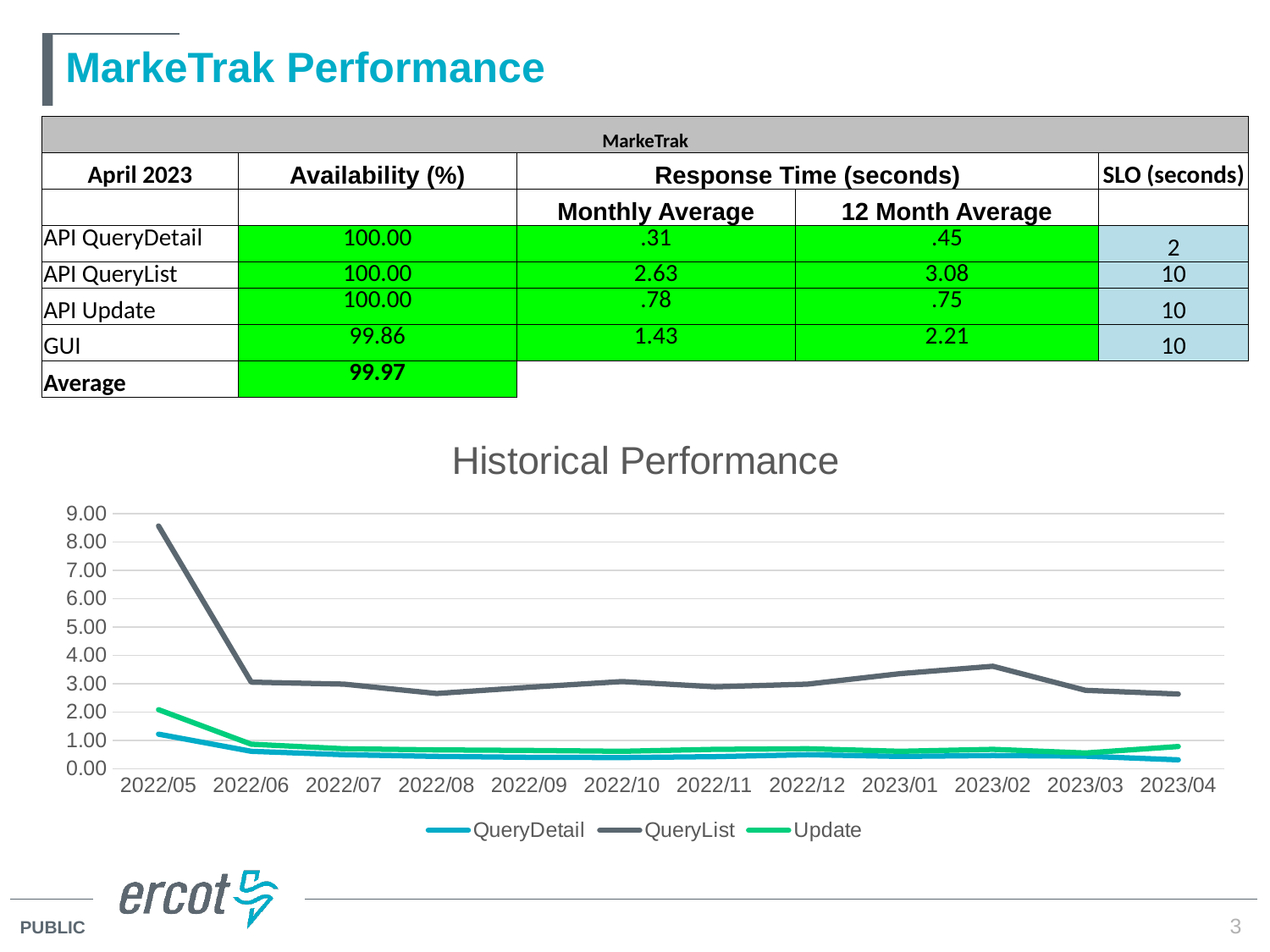
In the Historical Performance chart, is the QueryList value for 2022/05 greater or less than 8.00? greater In the Historical Performance chart, is the QueryList value for 2022/06 greater or less than 4.00? less What is the title of the line chart on the slide? Historical Performance In the Historical Performance chart, which series has the lowest value at 2023/04? QueryDetail How many months are plotted along the x axis of the Historical Performance chart? 12 In the Historical Performance chart, does the QueryList line rise or fall from 2022/05 to 2022/06? fall How many series does the legend of the Historical Performance chart list? 3 In the Historical Performance chart, is the QueryDetail value for 2023/04 greater or less than 1.00? less In the Historical Performance chart, in which month does the QueryList line reach its highest value? 2022/05 Which series are listed in the legend of the Historical Performance chart? QueryDetail, QueryList, Update What kind of chart is the Historical Performance chart? line chart